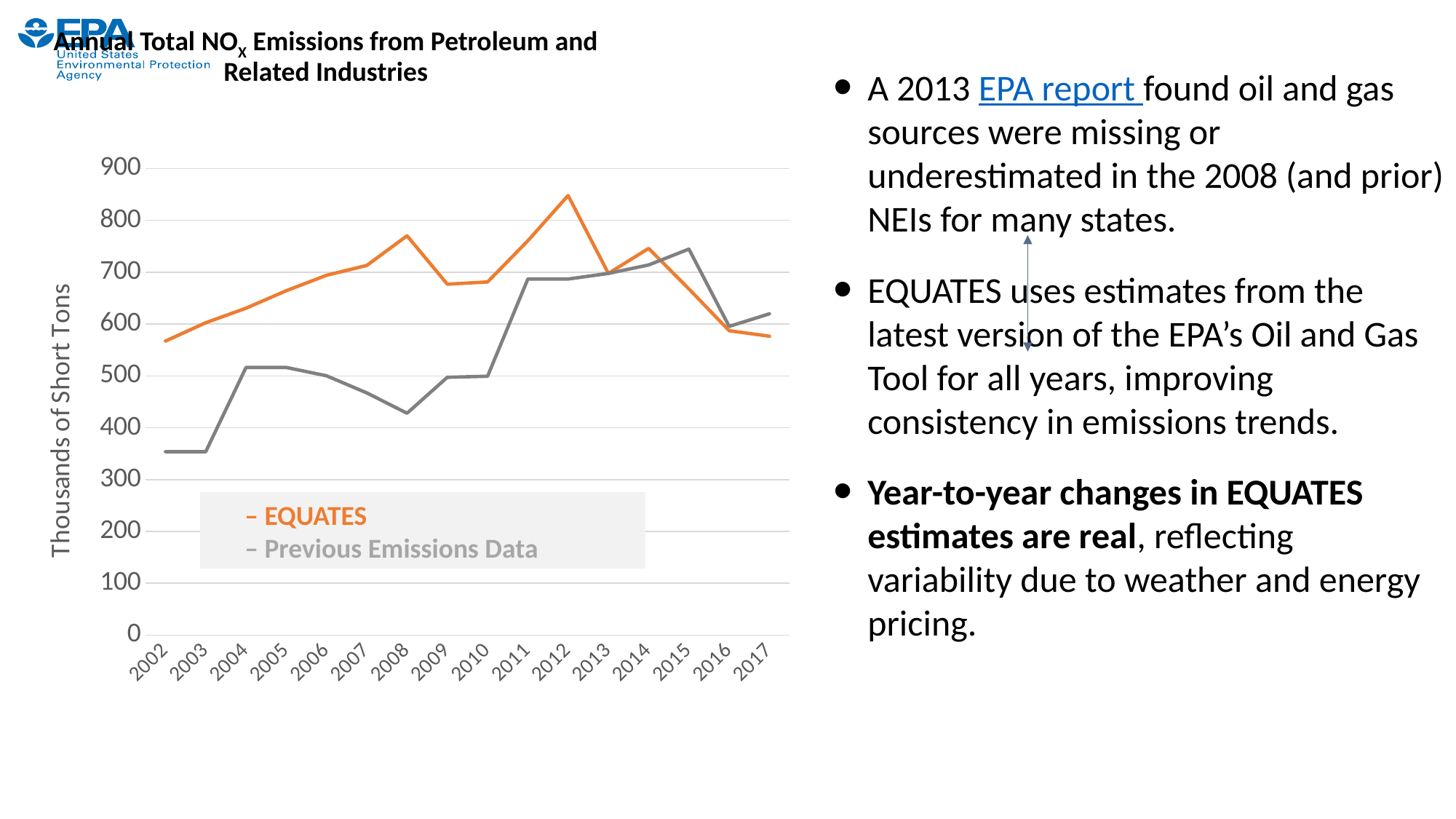
In 2015, which series has the larger value, EQUATES or Previous Emissions Data? Previous Emissions Data Does the Previous Emissions Data series rise or fall from 2002 to 2004? rise Is the EQUATES value for 2008 greater or less than 700? greater What kind of chart is shown on the slide? line chart How many years are shown along the x axis of the chart? 16 In which year does the Previous Emissions Data series reach its highest value? 2015 In 2008, which series has the larger value, EQUATES or Previous Emissions Data? EQUATES Is the Previous Emissions Data value for 2002 greater or less than 400? less In which year does the EQUATES series reach its highest value? 2012 What is the label on the y axis of the chart? Thousands of Short Tons Is the EQUATES value for 2012 greater or less than 800? greater How many series does the chart's legend list? 2